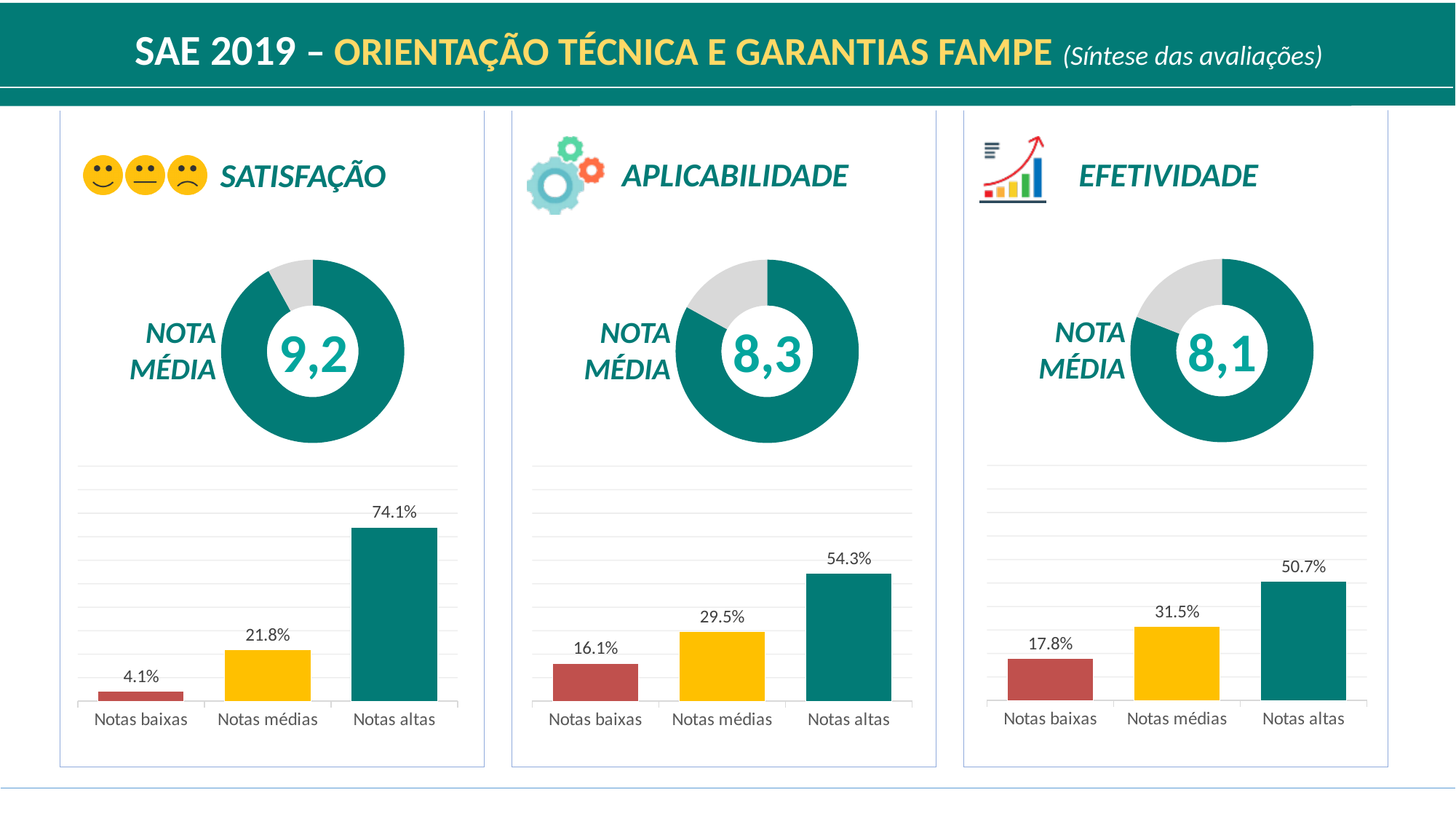
Do the values in the SATISFAÇÃO bar chart rise or fall from Notas baixas to Notas altas? Rise Which is larger: Notas médias in the EFETIVIDADE bar chart or Notas médias in the APLICABILIDADE bar chart? EFETIVIDADE In the SATISFAÇÃO bar chart, what is the difference between Notas médias and Notas baixas? 17.7% What NOTA MÉDIA is shown in the centre of the APLICABILIDADE donut chart? 8,3 In the APLICABILIDADE bar chart, what is the value for Notas médias? 29.5% In the EFETIVIDADE bar chart, which category has the highest value? Notas altas In the SATISFAÇÃO bar chart, what is the value for Notas altas? 74.1% What kind of chart is shown below the NOTA MÉDIA donut in the EFETIVIDADE panel? Bar chart In the SATISFAÇÃO bar chart, which category has the lowest value? Notas baixas In the APLICABILIDADE bar chart, what is the difference between Notas altas and Notas baixas? 38.2% In the EFETIVIDADE bar chart, what is the value for Notas baixas? 17.8% How many categories does the APLICABILIDADE bar chart show? 3